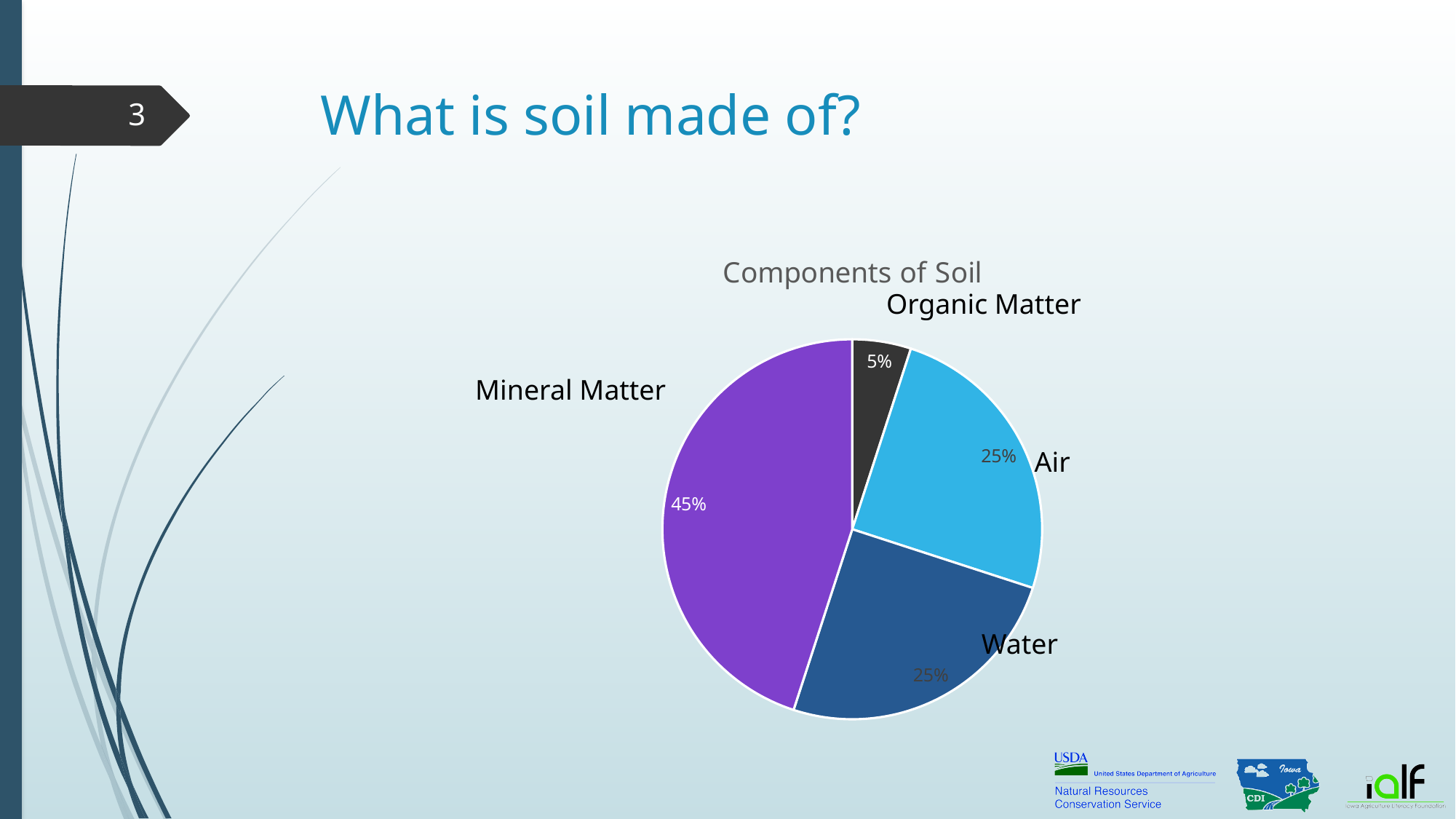
What percentage of soil is Water according to the chart? 25% What kind of chart is shown on the slide? pie chart Which is larger, the Mineral Matter slice or the Water slice? Mineral Matter What percentage of soil is Organic Matter according to the chart? 5% What percentage of soil is Air according to the chart? 25% Which component has the largest slice of the pie? Mineral Matter How many slices does the pie chart have? 4 What is the difference in percentage points between Mineral Matter and Air? 20 What colour is the Mineral Matter slice? purple Which component has the smallest slice of the pie? Organic Matter What percentage of soil is Mineral Matter according to the chart? 45% What is the title of the chart? Components of Soil